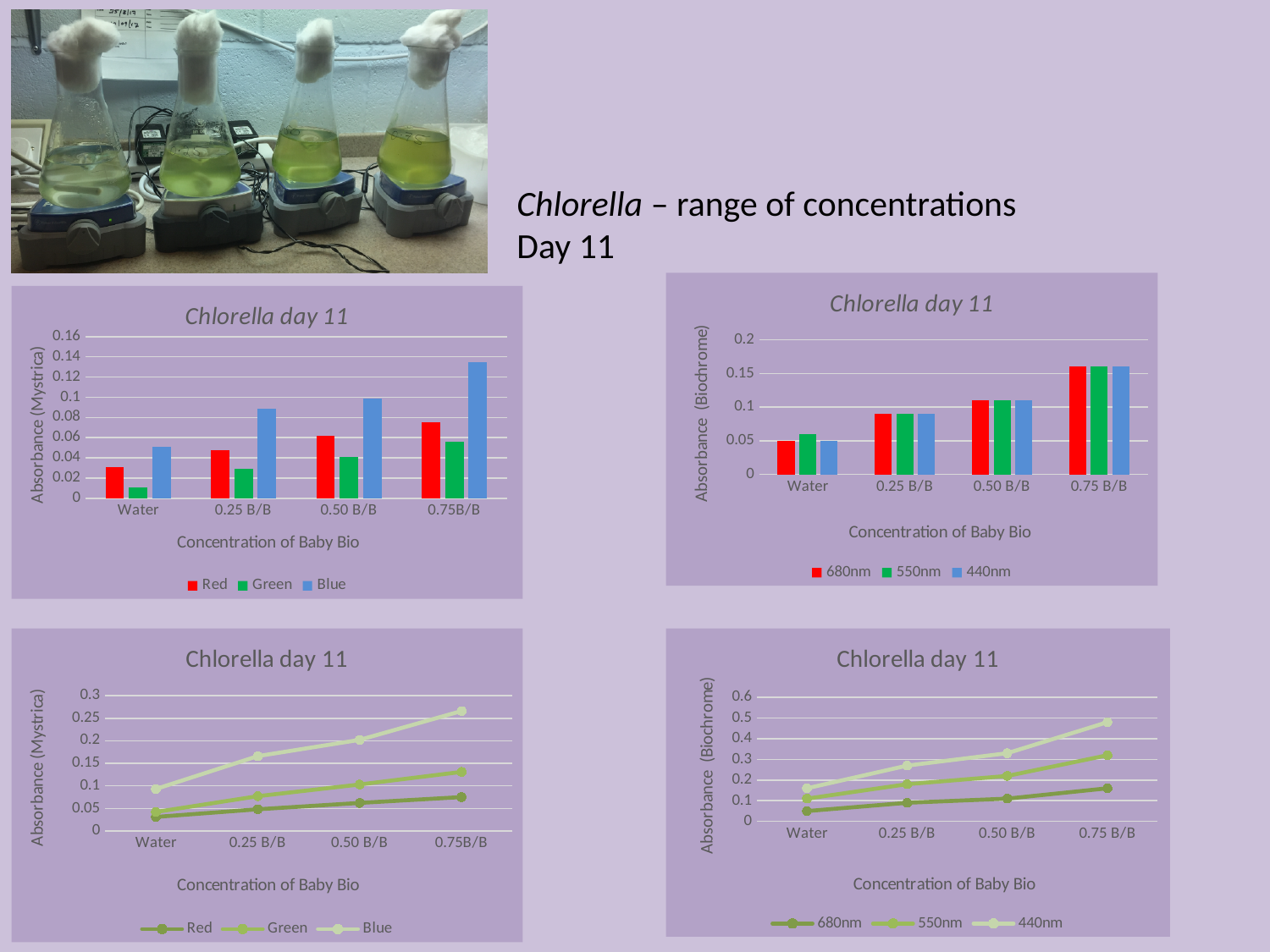
In the top-left bar chart, which category has the lowest Green bar? Water What kind of chart is the bottom-right chart on the slide? line chart In the top-right bar chart, is the 440nm value for 0.75 B/B greater or less than 0.15? greater In the top-left bar chart, how many concentration categories are shown on the x axis? 4 In the bottom-left line chart, does the Blue line rise or fall as the concentration of Baby Bio increases? rise In the top-left bar chart, is the Blue value for 0.75B/B greater or less than 0.12? greater In the top-right bar chart, what are the three series named in the legend? 680nm, 550nm, 440nm In the top-right bar chart, is the 680nm value for Water greater or less than 0.1? less What kind of chart is the top-left chart on the slide? bar chart In the top-left bar chart, which category has the highest Blue bar? 0.75B/B In the top-left bar chart, how many series does the legend list? 3